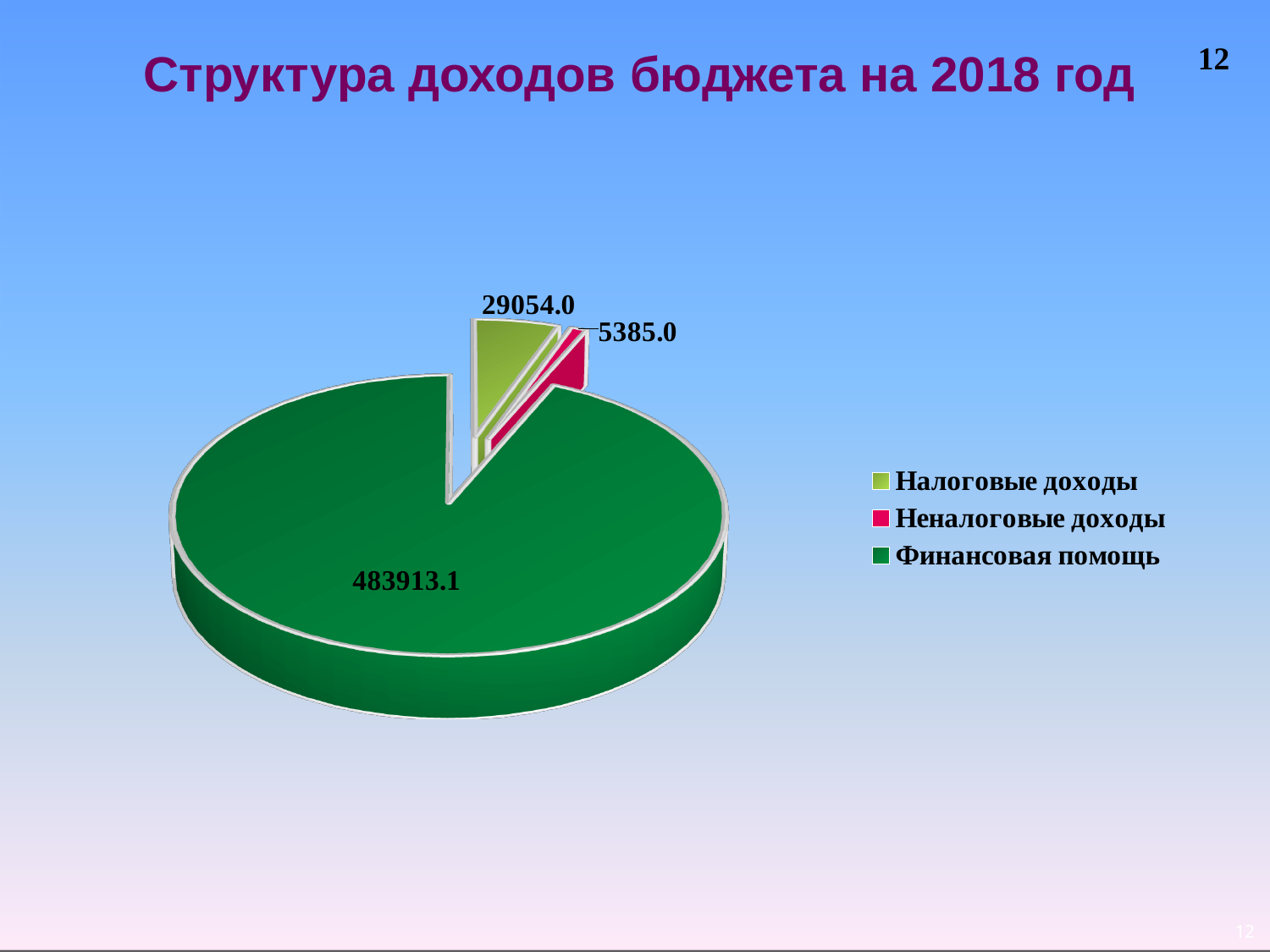
What is the value for Налоговые доходы? 29054.0 Which is larger, Налоговые доходы or Неналоговые доходы? Налоговые доходы What is the difference between the values for Налоговые доходы and Неналоговые доходы? 23669.0 What is the title of the slide containing the chart? Структура доходов бюджета на 2018 год How many slices does the pie chart have? 3 What is the value for Неналоговые доходы? 5385.0 Which category has the smallest slice of the pie? Неналоговые доходы What type of chart is shown on the slide? Pie chart Which category has the largest slice of the pie? Финансовая помощь What colour is the slice for Неналоговые доходы? Red What is the value for Финансовая помощь? 483913.1 What is the difference between the values for Финансовая помощь and Налоговые доходы? 454859.1